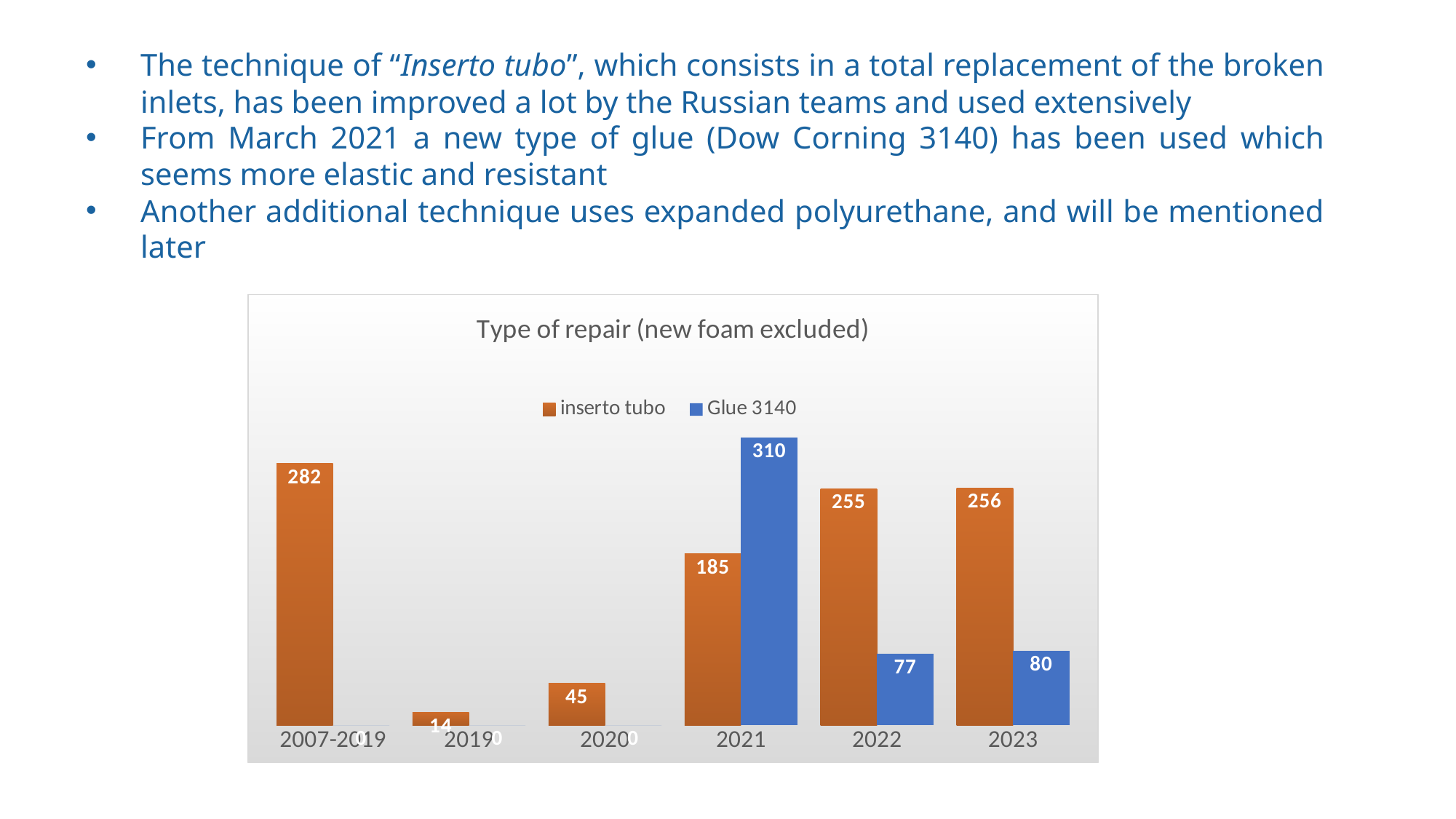
What is the value for inserto tubo in 2020? 45 In which year is the inserto tubo value lowest? 2019 In which year is the Glue 3140 value highest? 2021 What is the title of the chart? Type of repair (new foam excluded) How many series does the legend list? 2 What is the value for Glue 3140 in 2021? 310 How many year categories are shown on the x axis? 6 What is the value for Glue 3140 in 2023? 80 Which is larger in 2022, inserto tubo or Glue 3140? inserto tubo What is the difference between the Glue 3140 value and the inserto tubo value in 2021? 125 What kind of chart is shown? bar chart What is the value for inserto tubo in 2007-2019? 282